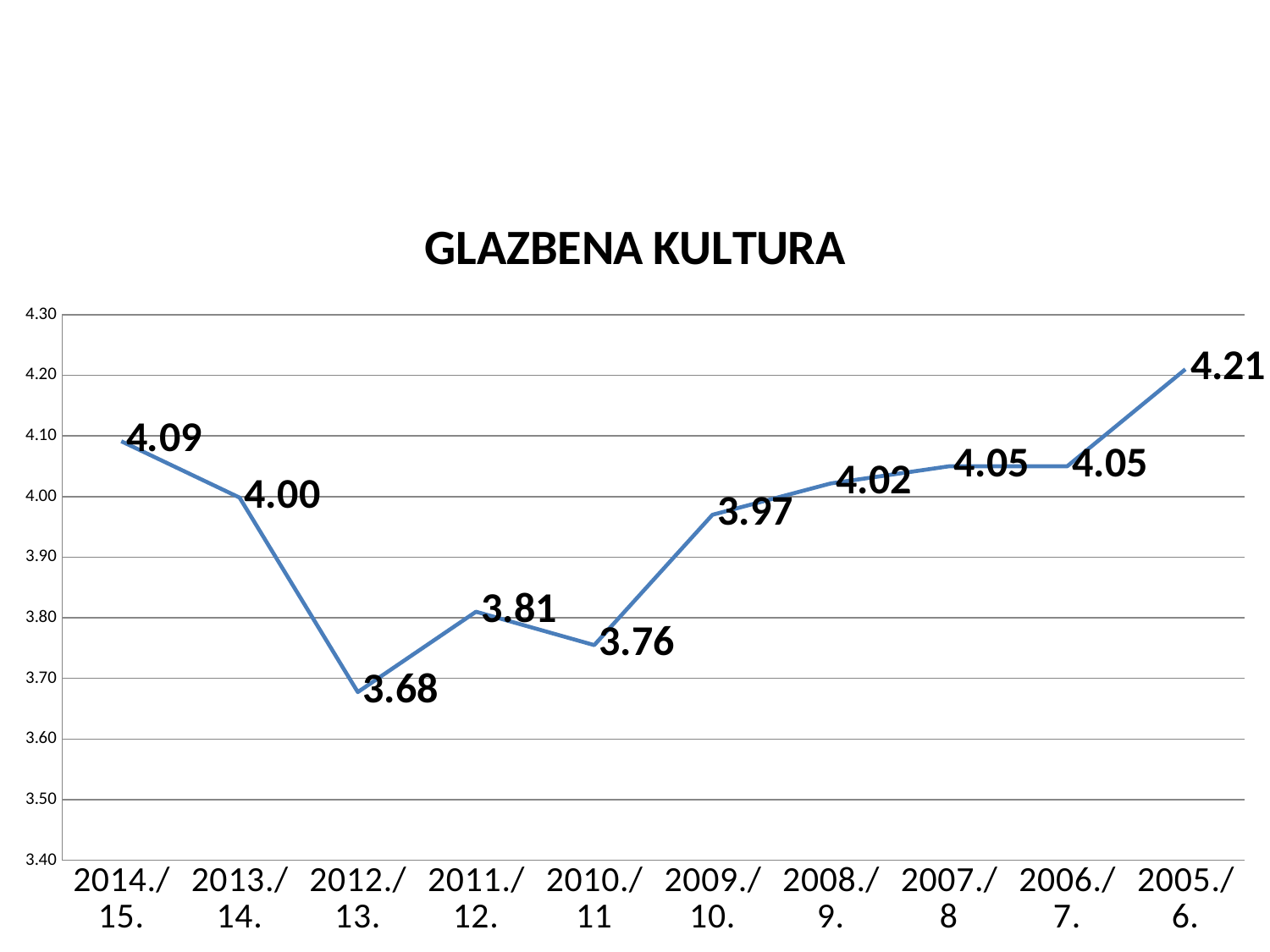
What is the value for 2012./13.? 3.68 Is the value for 2008./9. greater or less than 4.00? greater How many categories are shown on the x axis? 10 What is the difference between the values for 2005./6. and 2012./13.? 0.53 What is the title of the chart? GLAZBENA KULTURA What kind of chart is this? line chart Which category has the lowest value? 2012./13. Which is larger, the value for 2011./12. or the value for 2010./11? 2011./12. What is the value for 2009./10.? 3.97 Which category has the highest value? 2005./6. Do the values rise or fall from 2010./11 to 2005./6. along the x axis? rise What is the value for 2014./15.? 4.09